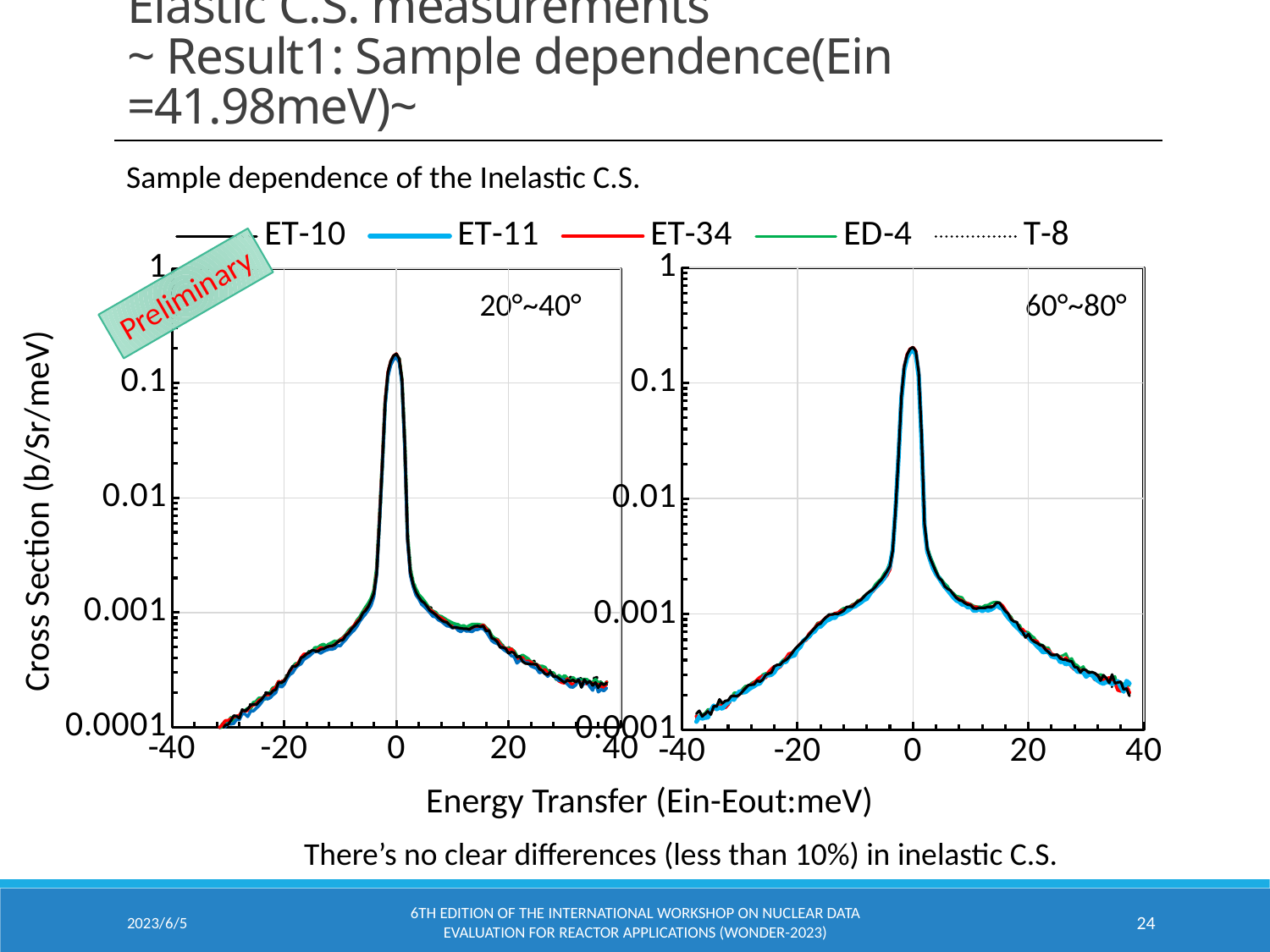
What angular range is labelled on the right chart? 60°~80° In the left (20°~40°) chart, do the curves rise or fall as energy transfer goes from -40 to 0? rise In the left (20°~40°) chart, is the value at an energy transfer of 20 greater or less than 0.001? less In the right (60°~80°) chart, is the peak value at an energy transfer of 0 greater or less than 0.1? greater In the right (60°~80°) chart, do the curves rise or fall as energy transfer goes from 0 to 40? fall How many series does the legend list? 5 In the left (20°~40°) chart, is the peak value at an energy transfer of 0 greater or less than 0.1? greater What is the x-axis title shared by the two charts? Energy Transfer (Ein-Eout:meV) What kind of chart is shown on the left (20°~40°) panel? line chart Which series is drawn in red in the legend? ET-34